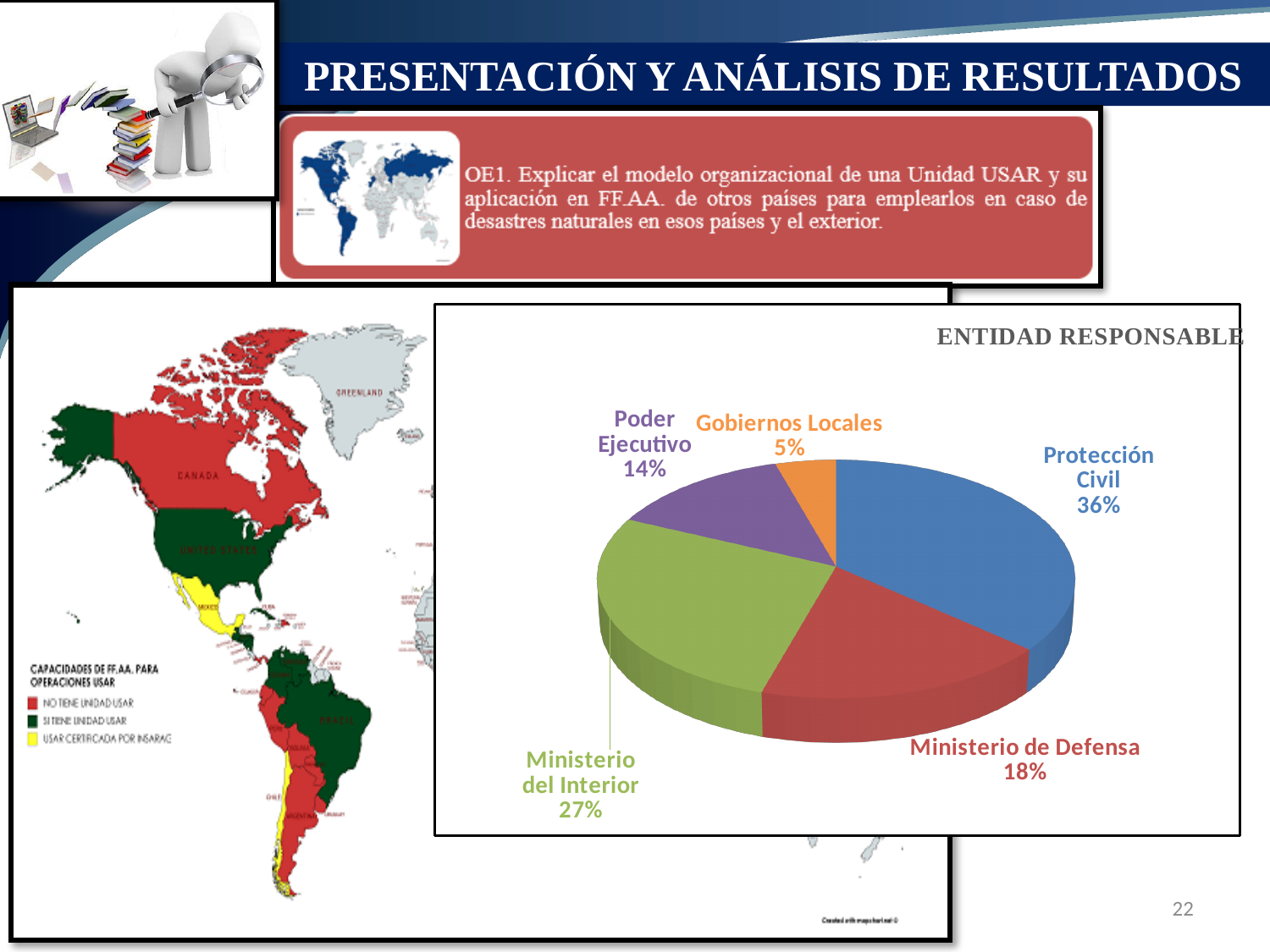
Which category has the smallest slice of the pie? Gobiernos Locales What share of the pie does Poder Ejecutivo represent? 14% What is the title of the pie chart? ENTIDAD RESPONSABLE Which is larger, the share for Ministerio del Interior or the share for Poder Ejecutivo? Ministerio del Interior What share of the pie does Protección Civil represent? 36% Which category has the largest slice of the pie? Protección Civil What share of the pie does Ministerio del Interior represent? 27% What share of the pie does Ministerio de Defensa represent? 18% What share of the pie does Gobiernos Locales represent? 5% How many categories are shown in the pie chart? 5 What is the difference in percentage points between Protección Civil and Ministerio de Defensa? 18% What type of chart is shown under the title 'ENTIDAD RESPONSABLE'? Pie chart